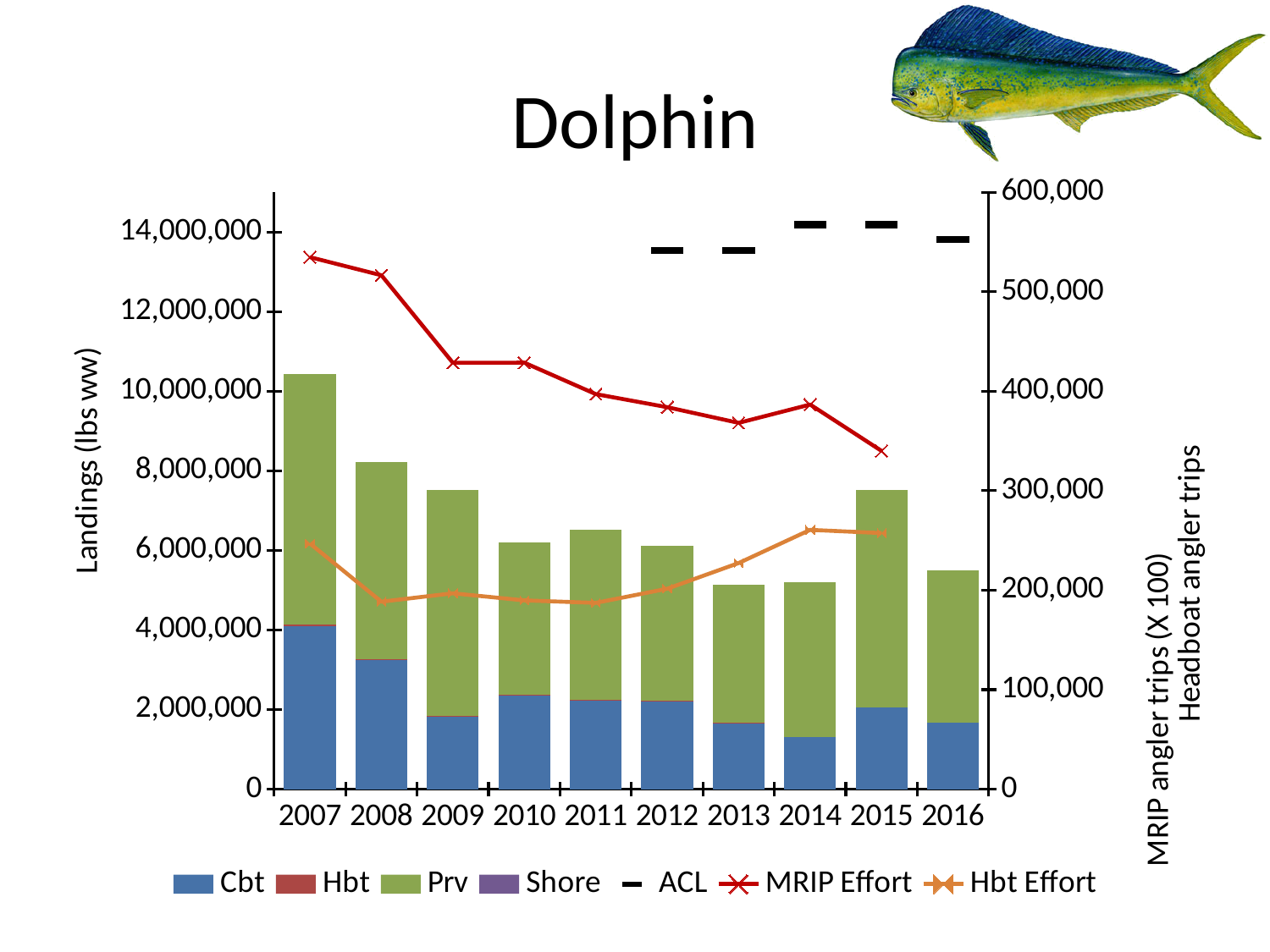
How many years are shown on the x axis? 10 Which year has the highest MRIP Effort value? 2007 What is the title of the chart? Dolphin Which year has the highest total landings bar? 2007 Is the total landings value for 2016 greater or less than 6,000,000? less Is the MRIP Effort value for 2015 greater or less than 400,000? less How many series does the legend list? 7 Which year has the lowest MRIP Effort value? 2015 Which year has larger total landings, 2015 or 2016? 2015 What kind of chart is this? Bar chart (stacked bars with line series) Is the total landings value for 2007 greater or less than 10,000,000? greater Does the MRIP Effort line generally rise or fall from 2007 to 2015? fall